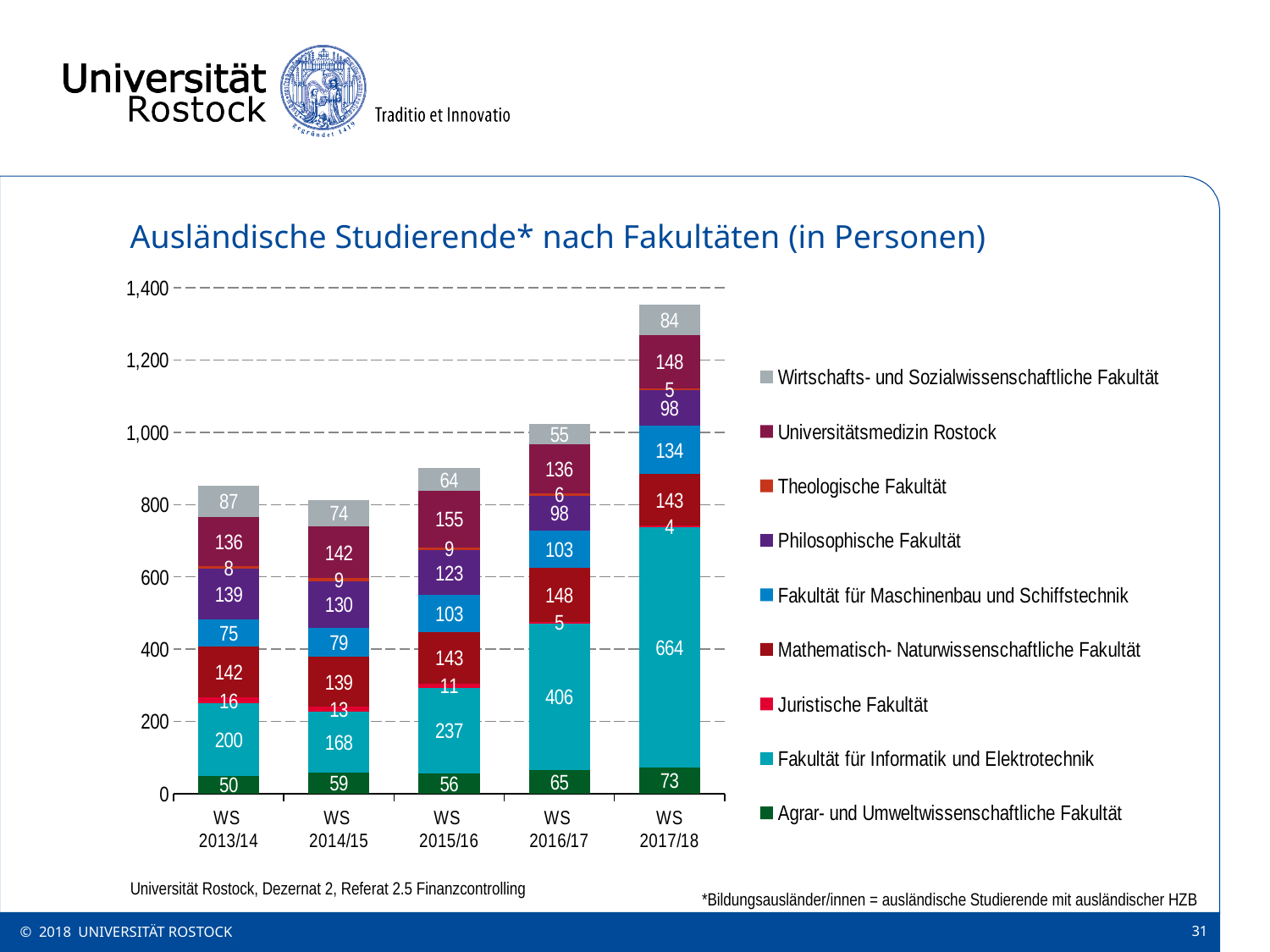
What is the value for Fakultät für Informatik und Elektrotechnik in WS 2017/18? 664 What is the difference between the Fakultät für Informatik und Elektrotechnik values in WS 2017/18 and WS 2016/17? 258 In which winter semester is the value for Juristische Fakultät lowest? WS 2017/18 Is the total of the stacked bar for WS 2016/17 greater or less than 1,000? greater What is the value for Agrar- und Umweltwissenschaftliche Fakultät in WS 2014/15? 59 How many series does the legend list? 9 What is the total of the stacked bar for WS 2017/18? 1353 Which is larger in WS 2013/14: the value for Mathematisch- Naturwissenschaftliche Fakultät or for Philosophische Fakultät? Mathematisch- Naturwissenschaftliche Fakultät How many winter semesters (categories) are shown on the x axis? 5 In which winter semester is the value for Fakultät für Informatik und Elektrotechnik highest? WS 2017/18 What type of chart is shown on the slide? Stacked bar chart What is the value for Universitätsmedizin Rostock in WS 2015/16? 155